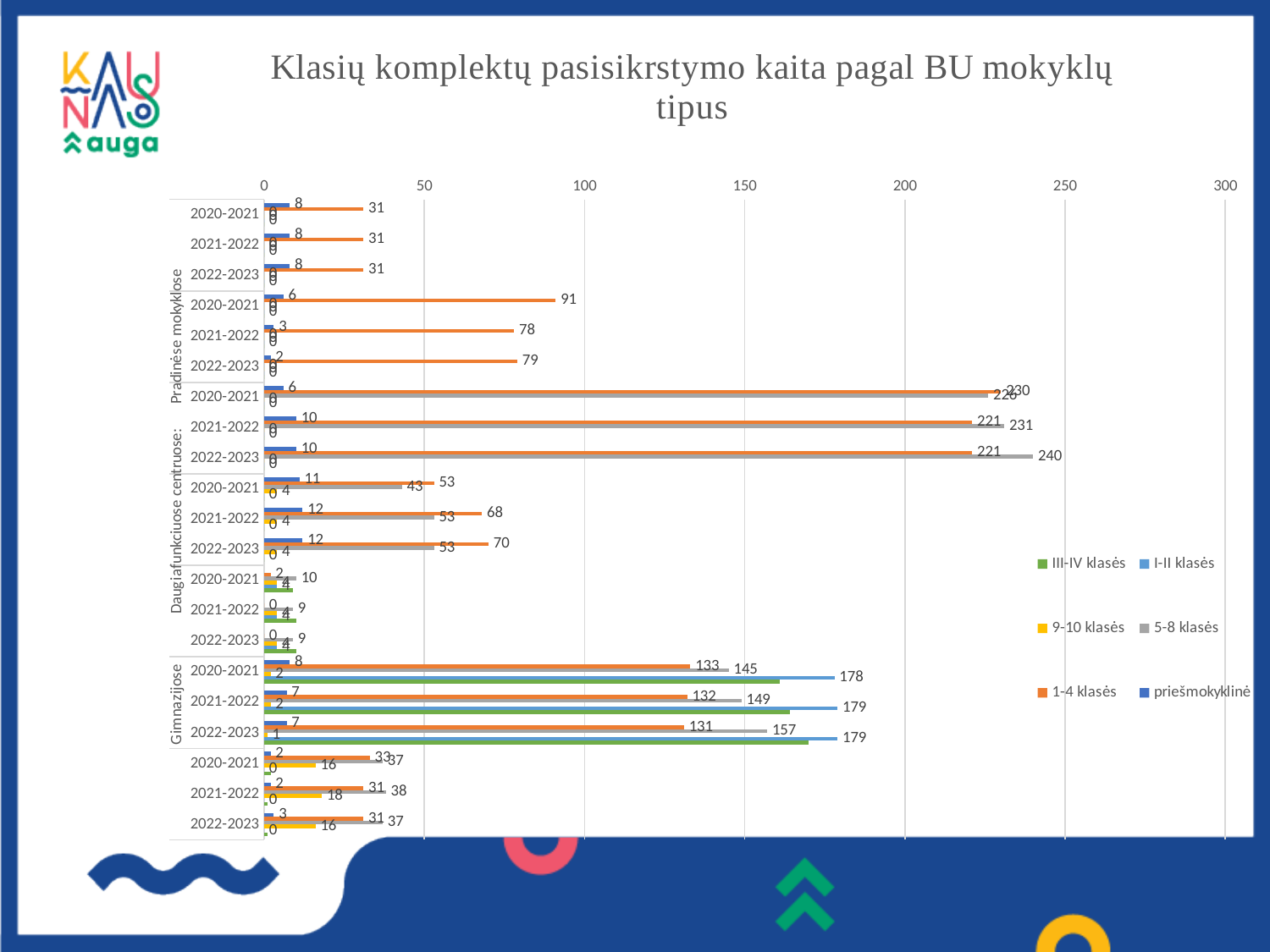
What is the title of the chart? Klasių komplektų pasisikrstymo kaita pagal BU mokyklų tipus In the Gimnazijose group for 2020-2021, which is larger: 5-8 klasės or 1-4 klasės? 5-8 klasės In the Gimnazijose group, do the 5-8 klasės values rise or fall from 2020-2021 to 2022-2023? rise In the Gimnazijose group, is the value for III-IV klasės in 2022-2023 greater or less than 150? greater In the Gimnazijose group, what is the value for I-II klasės in 2020-2021? 178 In the Gimnazijose group, what is the value for priešmokyklinė in 2020-2021? 8 How many series does the legend list? 6 In the Gimnazijose group, what is the value for 1-4 klasės in 2021-2022? 132 What kind of chart is shown on the slide? bar chart In the Gimnazijose group, what is the difference between the 5-8 klasės values for 2022-2023 and 2020-2021? 12 Which series is drawn in orange according to the legend? 1-4 klasės In the Gimnazijose group, what is the value for 5-8 klasės in 2022-2023? 157